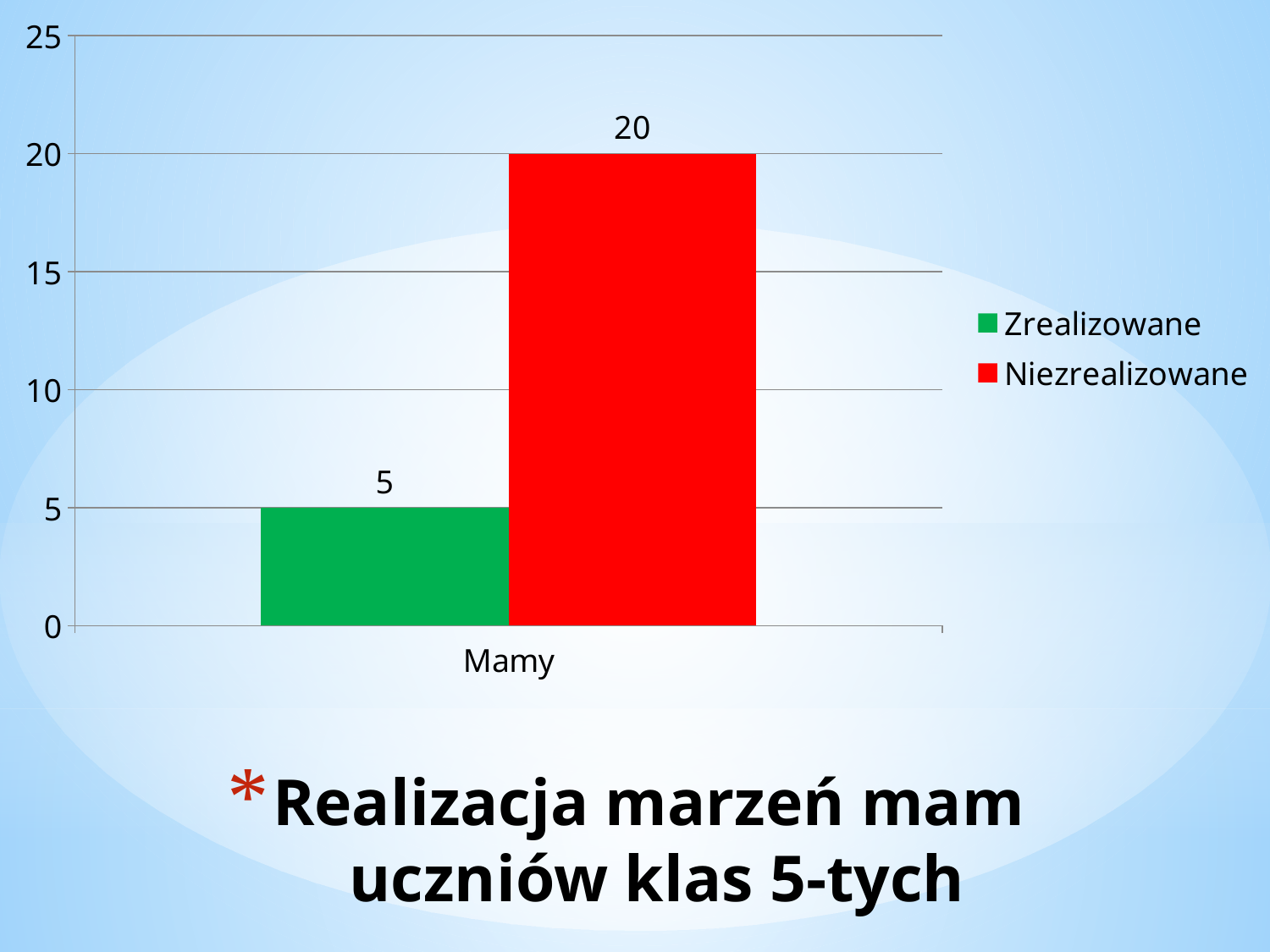
Is the value for Zrealizowane greater or less than 10? less How many series does the legend list? 2 What is the label of the category on the x axis? Mamy How many categories are shown on the x axis? 1 Which series has the lower value for Mamy? Zrealizowane What colour is the Niezrealizowane bar? red What is the value for Zrealizowane in the Mamy category? 5 What is the value for Niezrealizowane in the Mamy category? 20 Is the value for Niezrealizowane greater or less than 15? greater Which series has the higher value for Mamy? Niezrealizowane What is the difference between the Niezrealizowane and Zrealizowane values? 15 What kind of chart is shown on the slide? bar chart